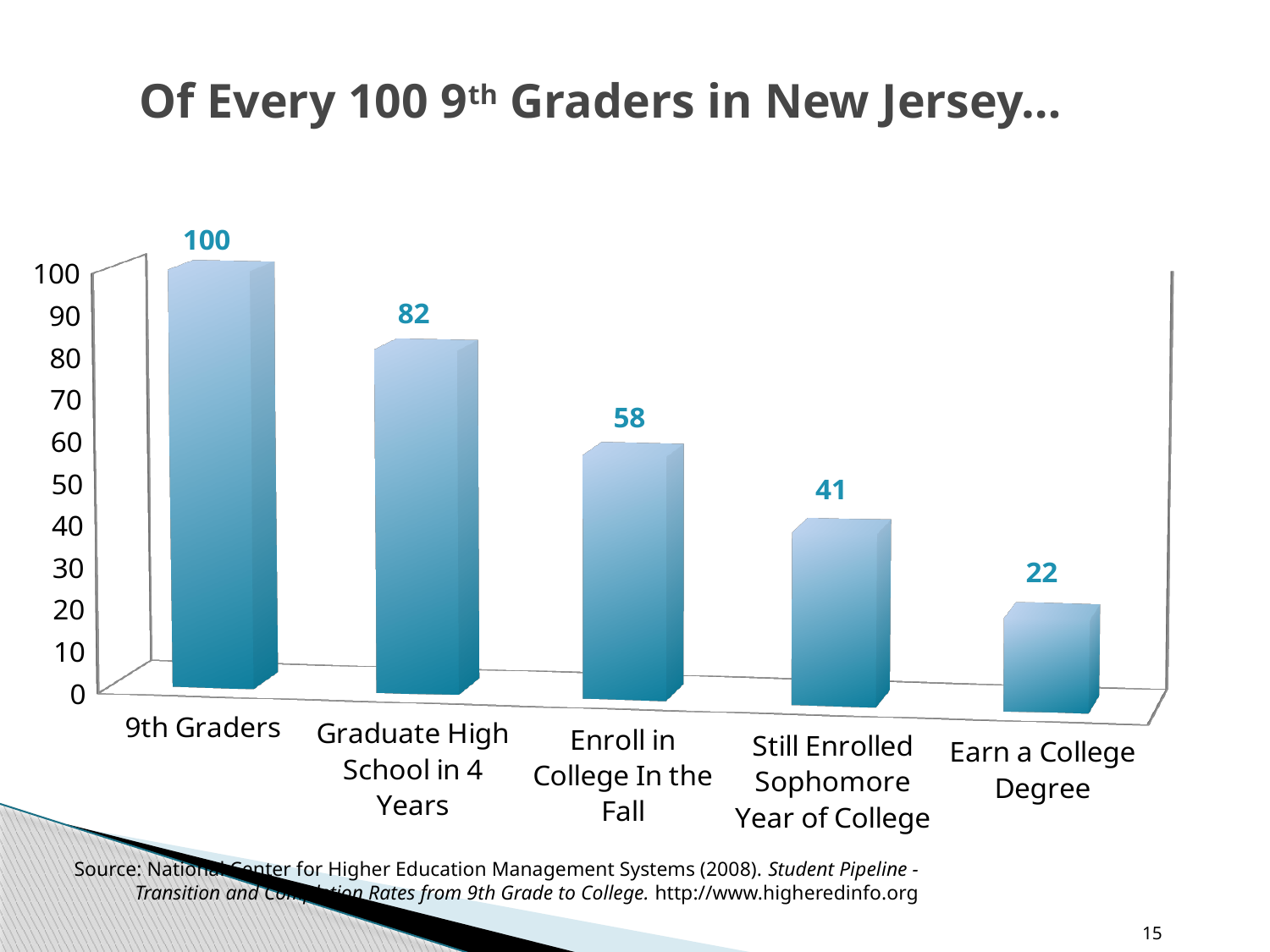
What is the value for Graduate High School in 4 Years? 82 What is the difference between the values for 9th Graders and Earn a College Degree? 78 Do the values rise or fall from left to right along the x axis? Fall What kind of chart is shown on the slide? Bar chart What is the value for Still Enrolled Sophomore Year of College? 41 What is the value for Earn a College Degree? 22 Which category has the highest value? 9th Graders Which is larger, the value for Still Enrolled Sophomore Year of College or the value for Earn a College Degree? Still Enrolled Sophomore Year of College What is the difference between the values for Graduate High School in 4 Years and Enroll in College In the Fall? 24 How many categories are shown on the chart? 5 Which category has the lowest value? Earn a College Degree What is the value for Enroll in College In the Fall? 58